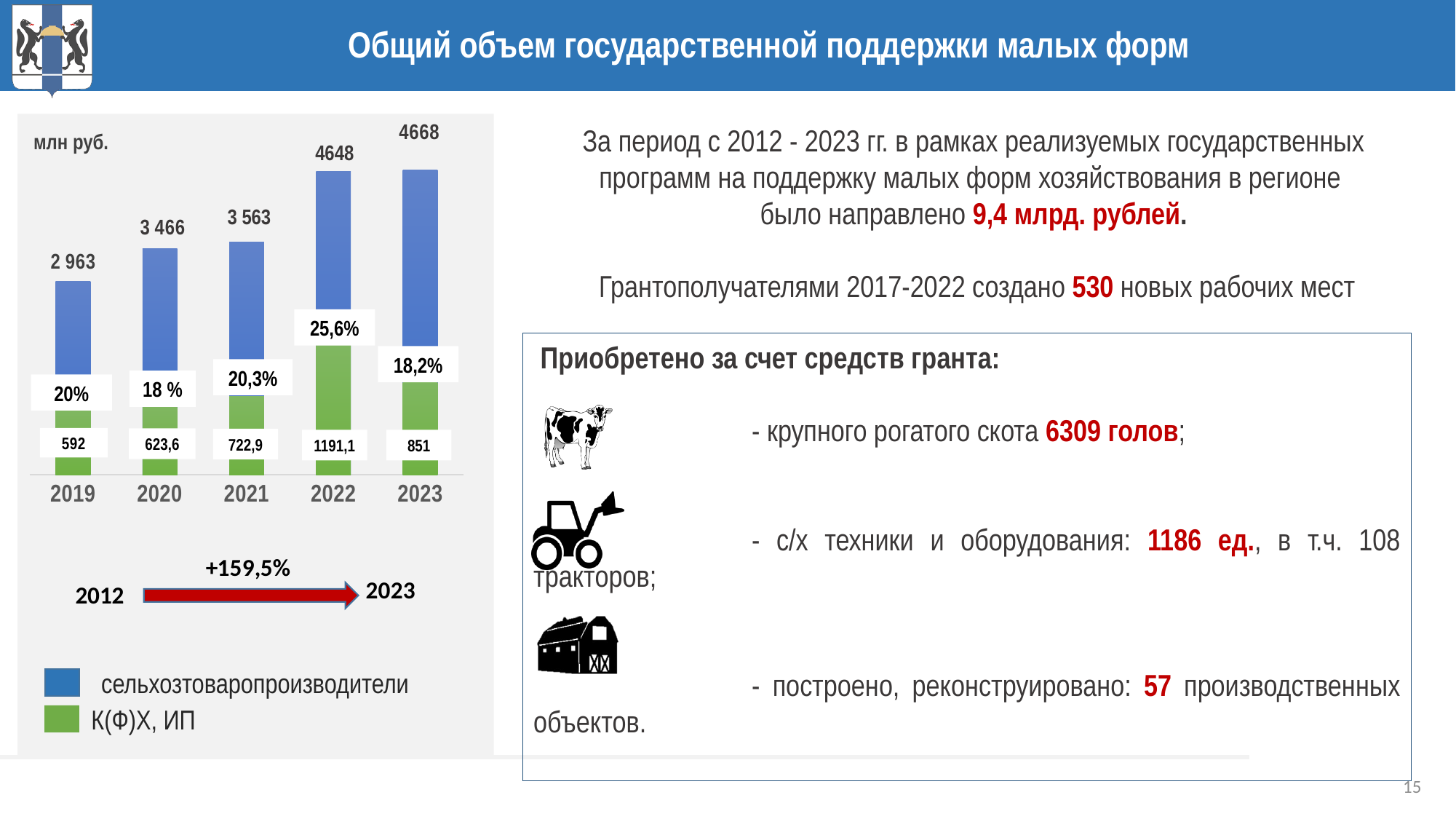
Which year has the lowest value for К(Ф)Х, ИП? 2019 How many years are shown on the x axis of the chart? 5 What is the value for К(Ф)Х, ИП in 2019? 592 How many series does the chart legend list? 2 What percentage is shown for 2020? 18 % What is the value for сельхозтоваропроизводители in 2021? 3 563 What kind of chart is shown on the slide? bar chart What unit is indicated in the top-left corner of the chart? млн руб. Which is larger, the К(Ф)Х, ИП value for 2022 or for 2023? 2022 Which year has the highest value for сельхозтоваропроизводители? 2023 What is the value for К(Ф)Х, ИП in 2022? 1191,1 What is the difference between the сельхозтоваропроизводители values for 2023 and 2022? 20